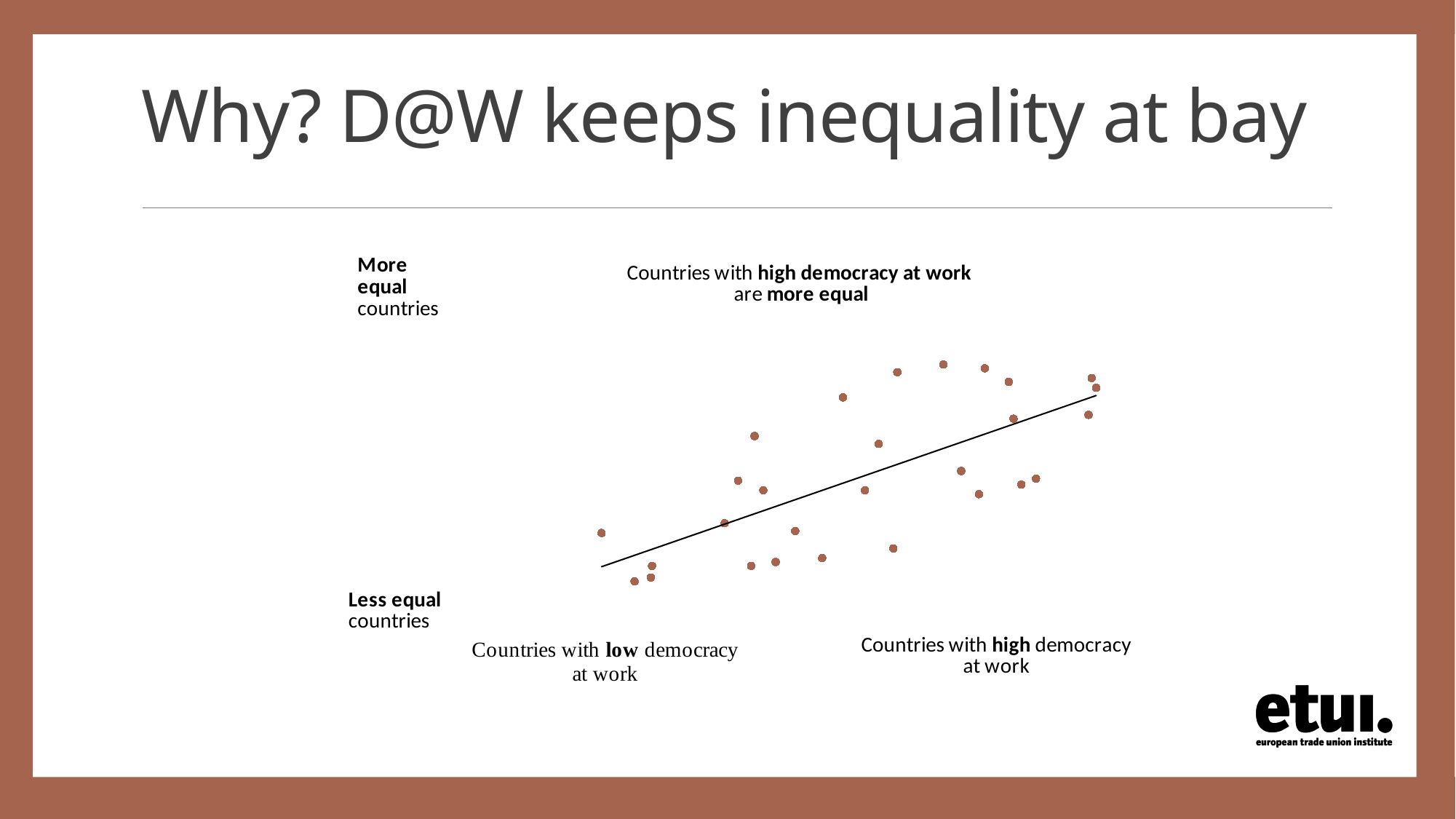
According to the annotation above the chart, countries with high democracy at work are what? more equal What kind of chart is shown on the slide? scatter chart Does the trend line in the scatter chart rise or fall from left to right? rise What label appears at the top of the vertical axis of the chart? More equal countries